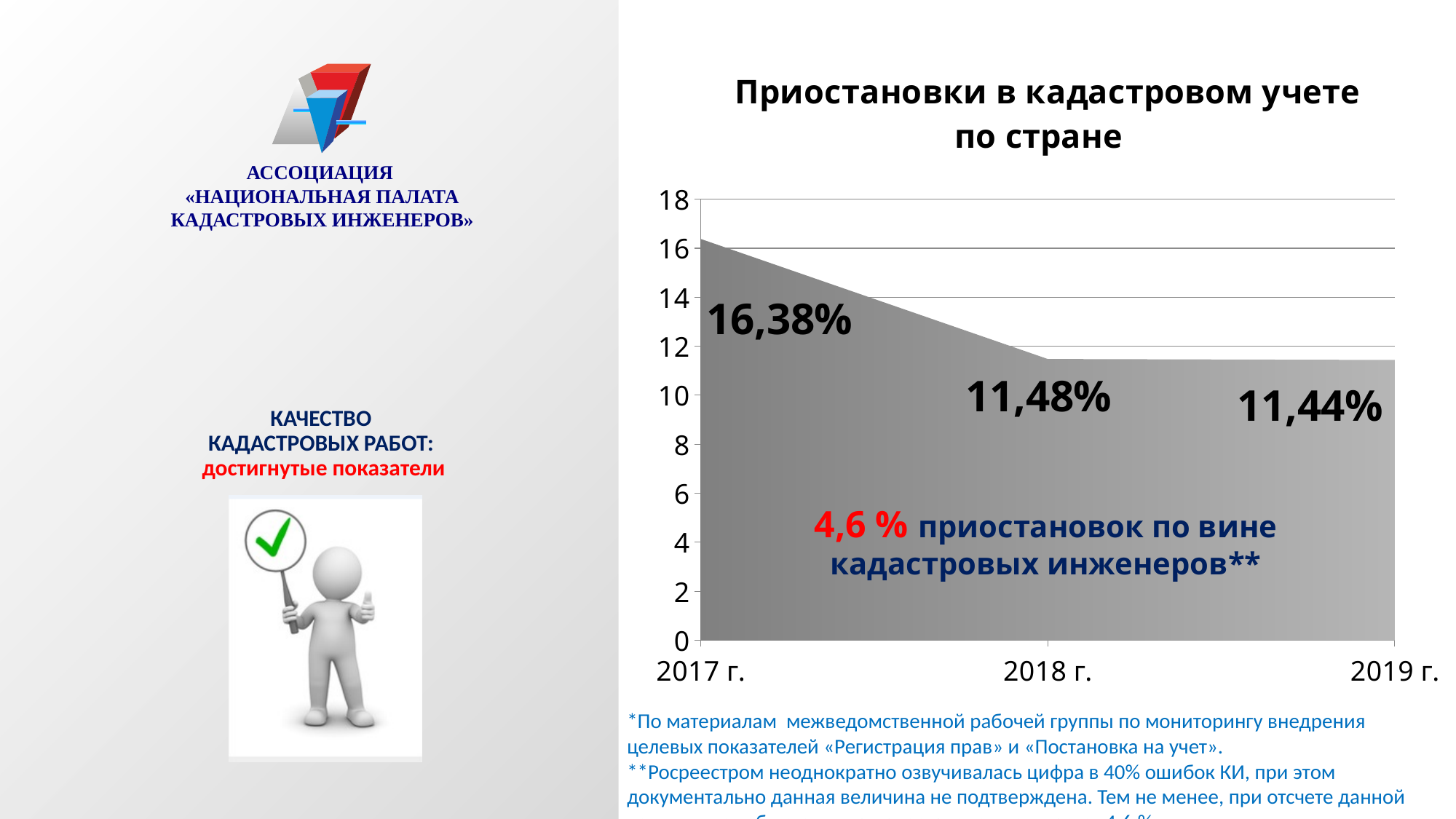
What value is shown for 2017 г.? 16,38% What value is shown for 2019 г.? 11,44% Which year has the highest value? 2017 г. Which year has the lowest value? 2019 г. What kind of chart is shown? area chart What is the difference between the values for 2018 г. and 2019 г.? 0,04% What value is shown for 2018 г.? 11,48% What is the difference between the values for 2017 г. and 2018 г.? 4,90% Which is larger, the value for 2017 г. or the value for 2018 г.? 2017 г. How many years are plotted on the chart? 3 Do the values rise or fall from 2017 г. to 2019 г.? fall Is the value for 2017 г. greater or less than 14? greater